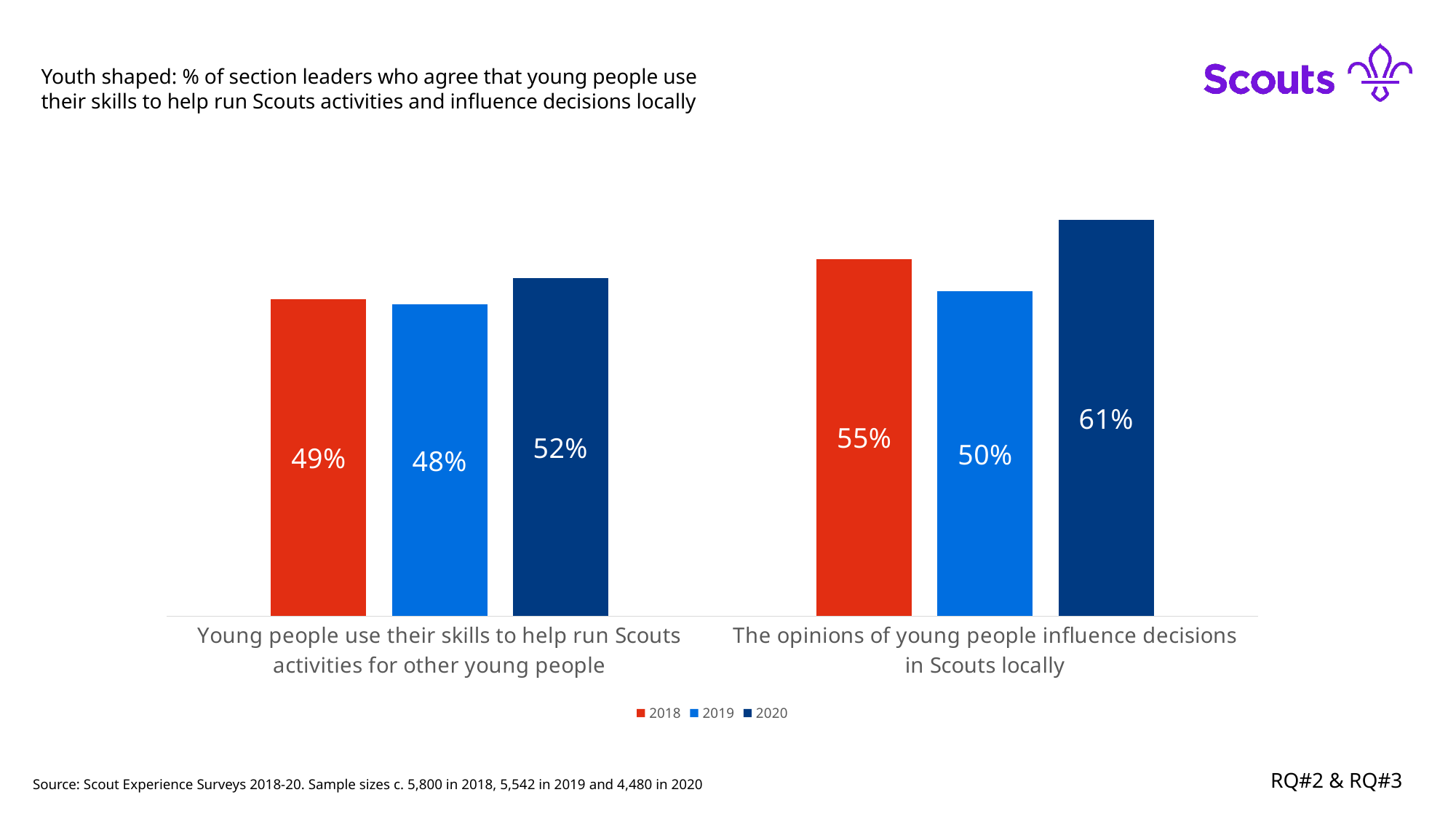
How many categories are shown on the x axis? 2 What percentage of section leaders agreed in 2020 that young people use their skills to help run Scouts activities for other young people? 52% What is the 2019 value for 'The opinions of young people influence decisions in Scouts locally'? 50% Which is larger: the 2018 value for 'Young people use their skills to help run Scouts activities for other young people' or the 2018 value for 'The opinions of young people influence decisions in Scouts locally'? The opinions of young people influence decisions in Scouts locally Which year has the highest value for 'The opinions of young people influence decisions in Scouts locally'? 2020 Which year has the lowest value for 'Young people use their skills to help run Scouts activities for other young people'? 2019 What is the difference between the 2020 and 2019 values for 'The opinions of young people influence decisions in Scouts locally'? 11 percentage points What kind of chart is shown on the slide? Bar chart How many series does the legend list? 3 What is the 2019 value for 'Young people use their skills to help run Scouts activities for other young people'? 48% What is the difference between the 2020 and 2018 values for 'Young people use their skills to help run Scouts activities for other young people'? 3 percentage points What percentage of section leaders agreed in 2018 that the opinions of young people influence decisions in Scouts locally? 55%